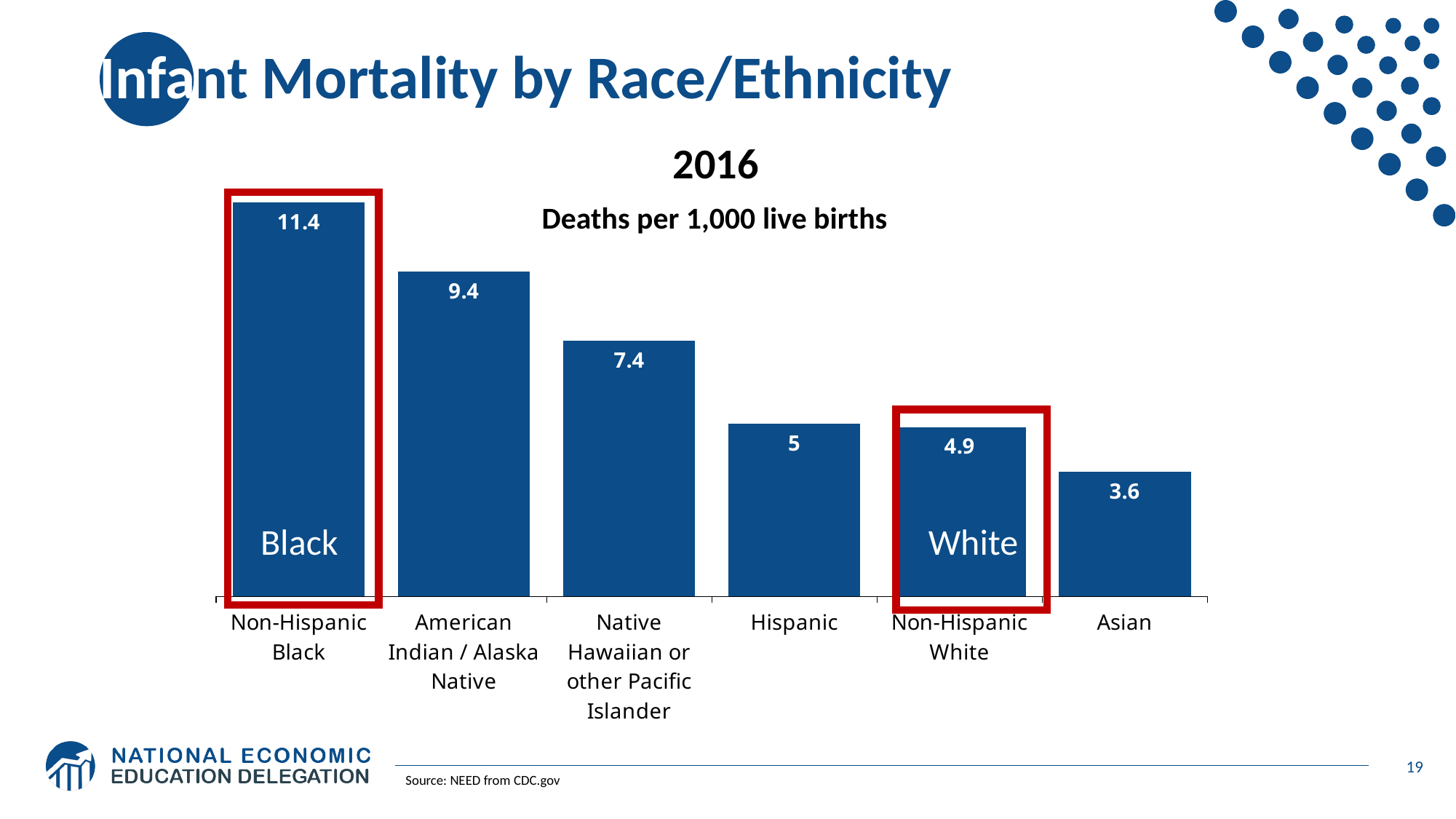
What unit is the chart measured in, according to the subtitle? Deaths per 1,000 live births What is the difference between the Native Hawaiian or other Pacific Islander rate and the Asian rate? 3.8 What is the value shown for Asian? 3.6 Which is larger, the value for Hispanic or the value for Non-Hispanic White? Hispanic What is the difference between the Non-Hispanic Black and Non-Hispanic White infant mortality rates? 6.5 What is the infant mortality rate for American Indian / Alaska Native? 9.4 How many race/ethnicity categories are shown in the chart? 6 What is the infant mortality rate for Non-Hispanic Black? 11.4 What kind of chart is shown on the slide? Bar chart Which race/ethnicity group has the lowest infant mortality rate? Asian Which race/ethnicity group has the highest infant mortality rate? Non-Hispanic Black What is the value shown for Hispanic? 5